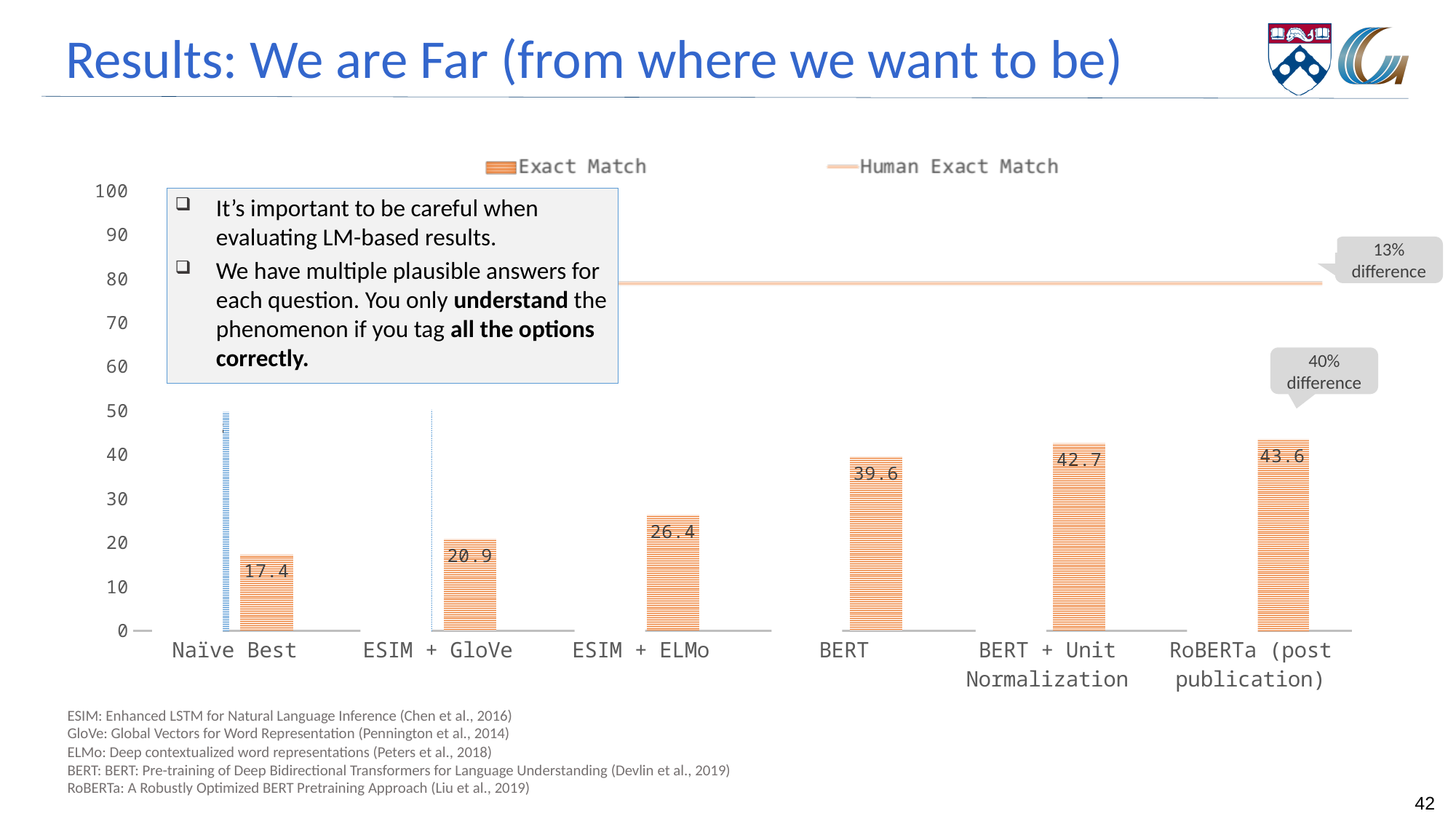
What is the Exact Match value for BERT? 39.6 How many series does the chart legend list? 2 What is the difference in Exact Match between BERT + Unit Normalization and BERT? 3.1 Which has a higher Exact Match score, ESIM + GloVe or ESIM + ELMo? ESIM + ELMo Which model has the lowest Exact Match score? Naïve Best Which model has the highest Exact Match score? RoBERTa (post publication) Is the Human Exact Match line greater or less than 70? greater Do the Exact Match scores rise or fall from left to right along the x axis? Rise How many models are shown on the x axis of the chart? 6 What kind of chart is used to show the Exact Match scores? Bar chart What is the Exact Match value for Naïve Best? 17.4 What is the Exact Match value for ESIM + ELMo? 26.4